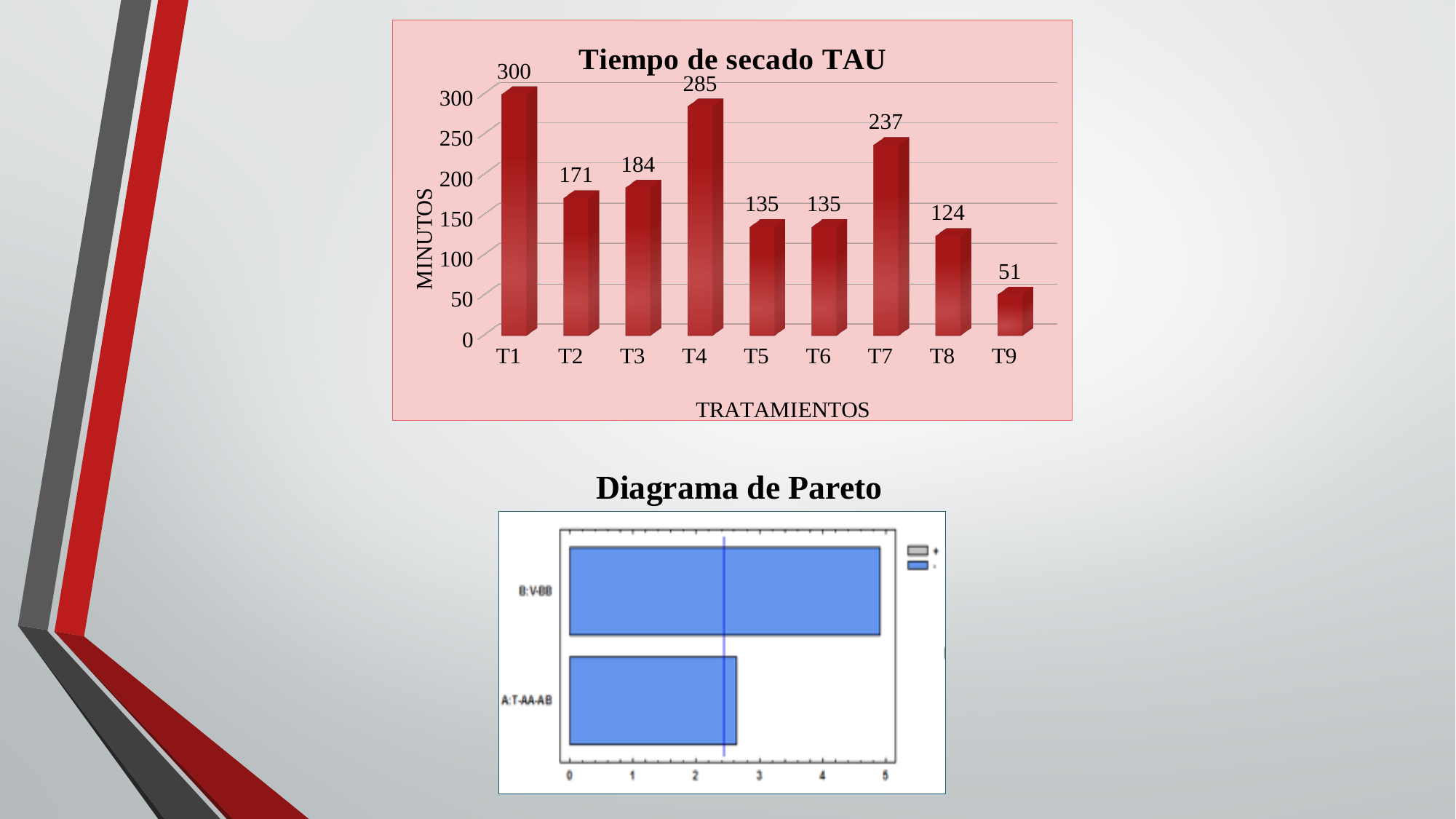
In the 'Tiempo de secado TAU' chart, what is the difference between the values for T1 and T9? 249 In the 'Tiempo de secado TAU' chart, what is the value for T7? 237 In the 'Tiempo de secado TAU' chart, what is the label of the y axis? MINUTOS In the 'Tiempo de secado TAU' chart, what is the value for T4? 285 In the 'Tiempo de secado TAU' chart, which is larger, the value for T2 or the value for T3? T3 In the 'Tiempo de secado TAU' chart, which treatment has the lowest drying time? T9 In the 'Tiempo de secado TAU' chart, how many treatments are shown on the x axis? 9 In the 'Tiempo de secado TAU' chart, which treatment has the highest drying time? T1 In the 'Diagrama de Pareto' chart, is the value for A:T-AA-AB greater or less than 3? less In the 'Diagrama de Pareto' chart, is the value of the top bar greater or less than 4? greater In the 'Diagrama de Pareto' chart, how many bars are plotted? 2 What kind of chart is 'Tiempo de secado TAU'? Bar chart